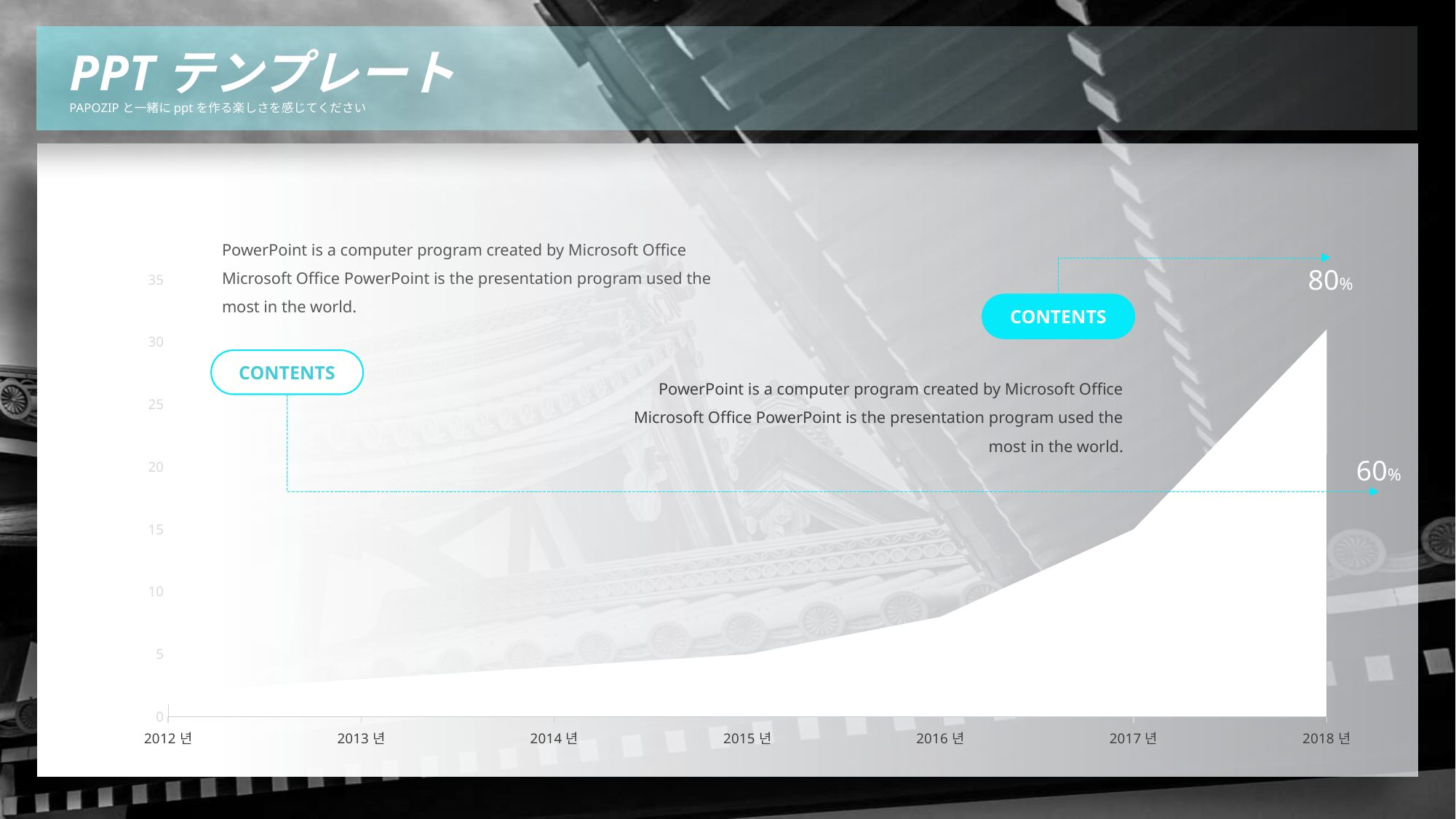
Is the value for 2013년 greater or less than 5? less Is the value for 2017년 greater or less than 20? less Which year has the lowest value in the chart? 2012년 Which is larger, the value for 2018년 or the value for 2017년? 2018년 Is the value for 2016년 greater or less than 15? less Do the values in the chart rise or fall from 2012년 to 2018년? rise Which is larger, the value for 2016년 or the value for 2014년? 2016년 What is the highest tick value shown on the chart's y axis? 35 What kind of chart is shown on the slide? area chart Which year has the highest value in the chart? 2018년 How many years are shown along the x axis of the chart? 7